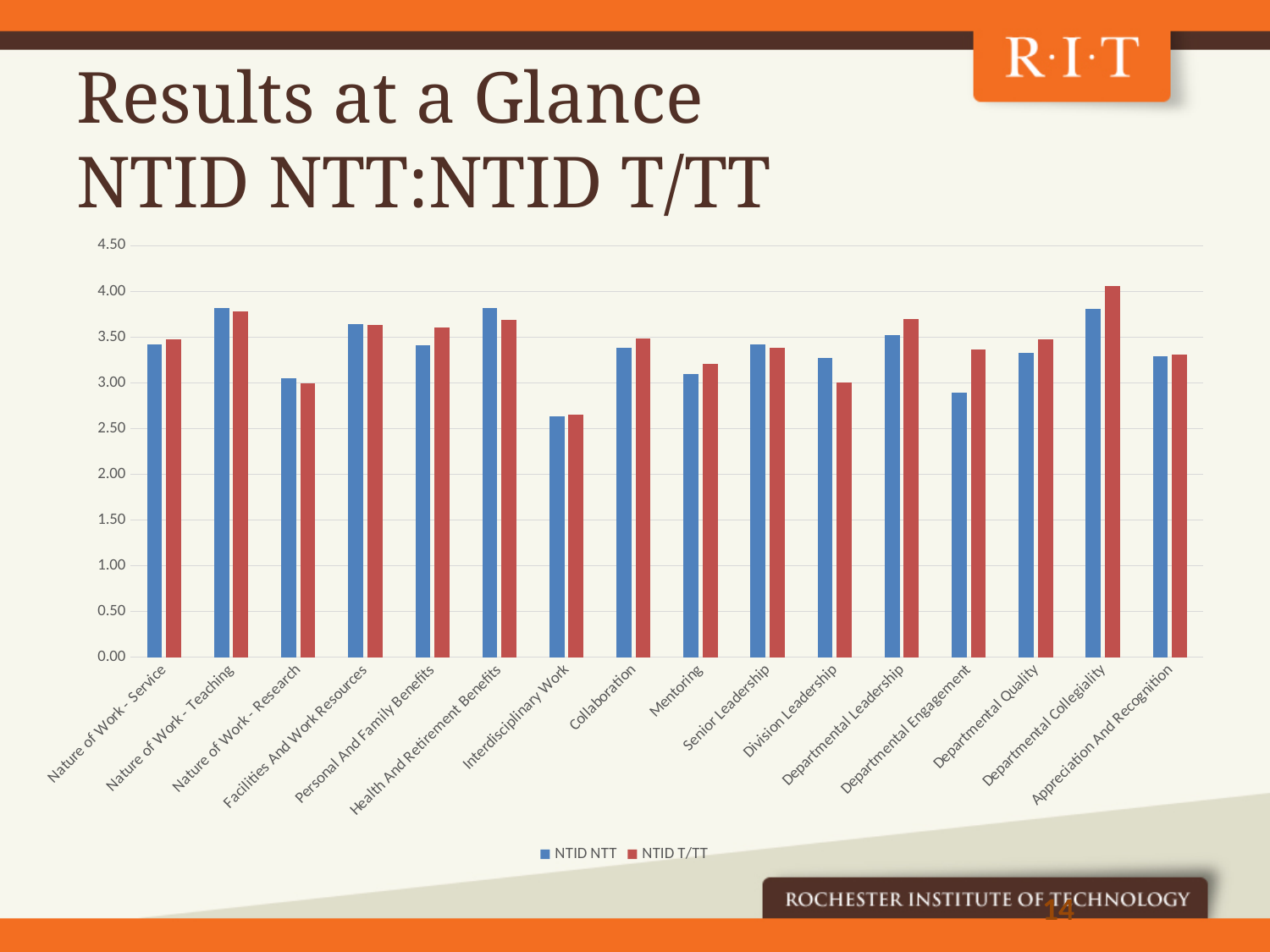
Which colour represents the NTID T/TT series in the legend? red Which category has the lowest value for NTID NTT? Interdisciplinary Work Which category has the lowest value for NTID T/TT? Interdisciplinary Work For Departmental Engagement, which series has the larger value, NTID NTT or NTID T/TT? NTID T/TT For Division Leadership, which series has the larger value, NTID NTT or NTID T/TT? NTID NTT How many series does the legend list? 2 How many categories are shown along the x axis? 16 Which category has the highest value for NTID T/TT? Departmental Collegiality Is the NTID NTT value for Departmental Engagement greater or less than 3.00? less What kind of chart is shown on the slide? bar chart Is the NTID NTT value for Interdisciplinary Work greater or less than 3.00? less Is the NTID T/TT value for Departmental Collegiality greater or less than 4.00? greater